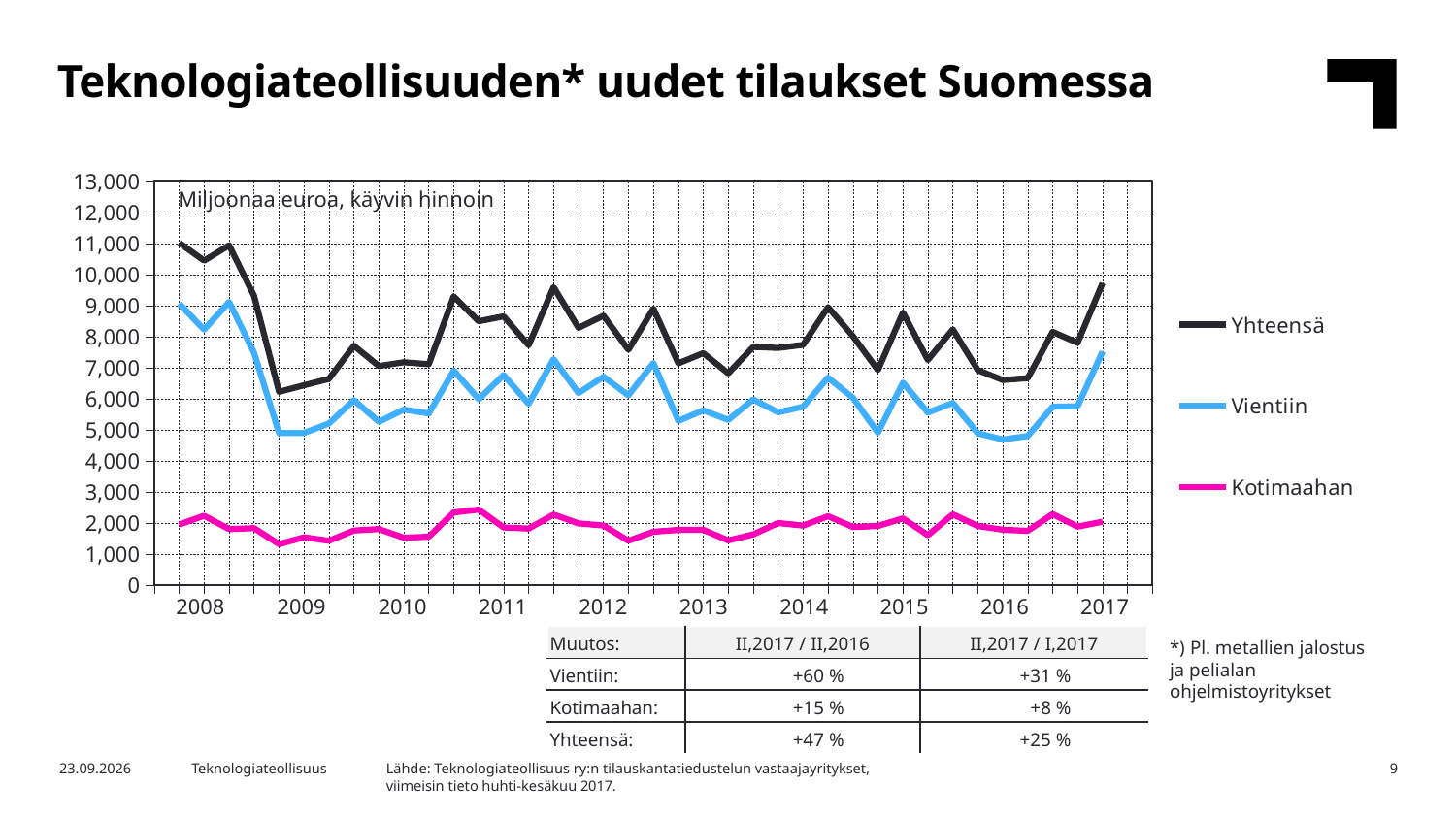
What are the three series named in the chart legend? Yhteensä, Vientiin, Kotimaahan Which series has the lowest values throughout the chart? Kotimaahan Does the Yhteensä line rise or fall from the start of 2008 to the start of 2009? fall Is the value for Vientiin at the start of 2009 greater or less than 6,000? less Which series is larger in 2014, Vientiin or Kotimaahan? Vientiin How many years are labelled on the x axis of the chart? 10 Which series has the highest values throughout the chart? Yhteensä Is the value for Kotimaahan in 2012 greater or less than 3,000? less How many series does the chart legend list? 3 What kind of chart is shown on the slide? line chart What unit label is printed inside the chart area? Miljoonaa euroa, käyvin hinnoin Is the value for Yhteensä at the end of 2017 greater or less than 8,000? greater